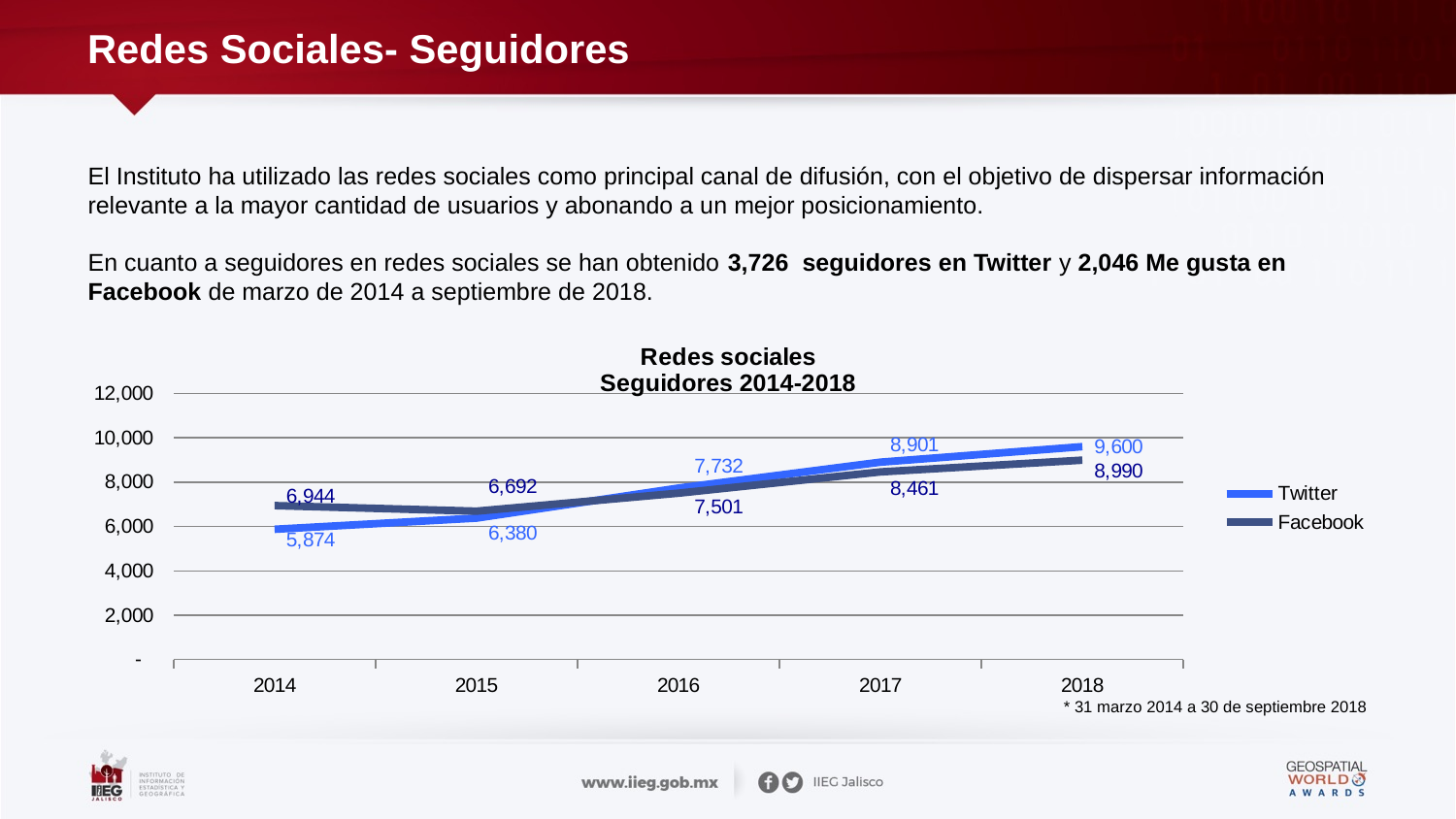
How many years are shown on the x axis? 5 In which year is the Twitter value lowest? 2014 Which series has the larger value in 2015, Twitter or Facebook? Facebook What is the Facebook value for 2014? 6,944 In which year is the Facebook value highest? 2018 What is the Twitter value for 2016? 7,732 Is the Facebook value for 2017 greater or less than 8,000? greater Does the Twitter series rise or fall from 2014 to 2018? Rise What type of chart is shown on the slide? Line chart How many series does the legend list? 2 What is the Twitter value for 2018? 9,600 What is the difference between the Twitter and Facebook values in 2018? 610